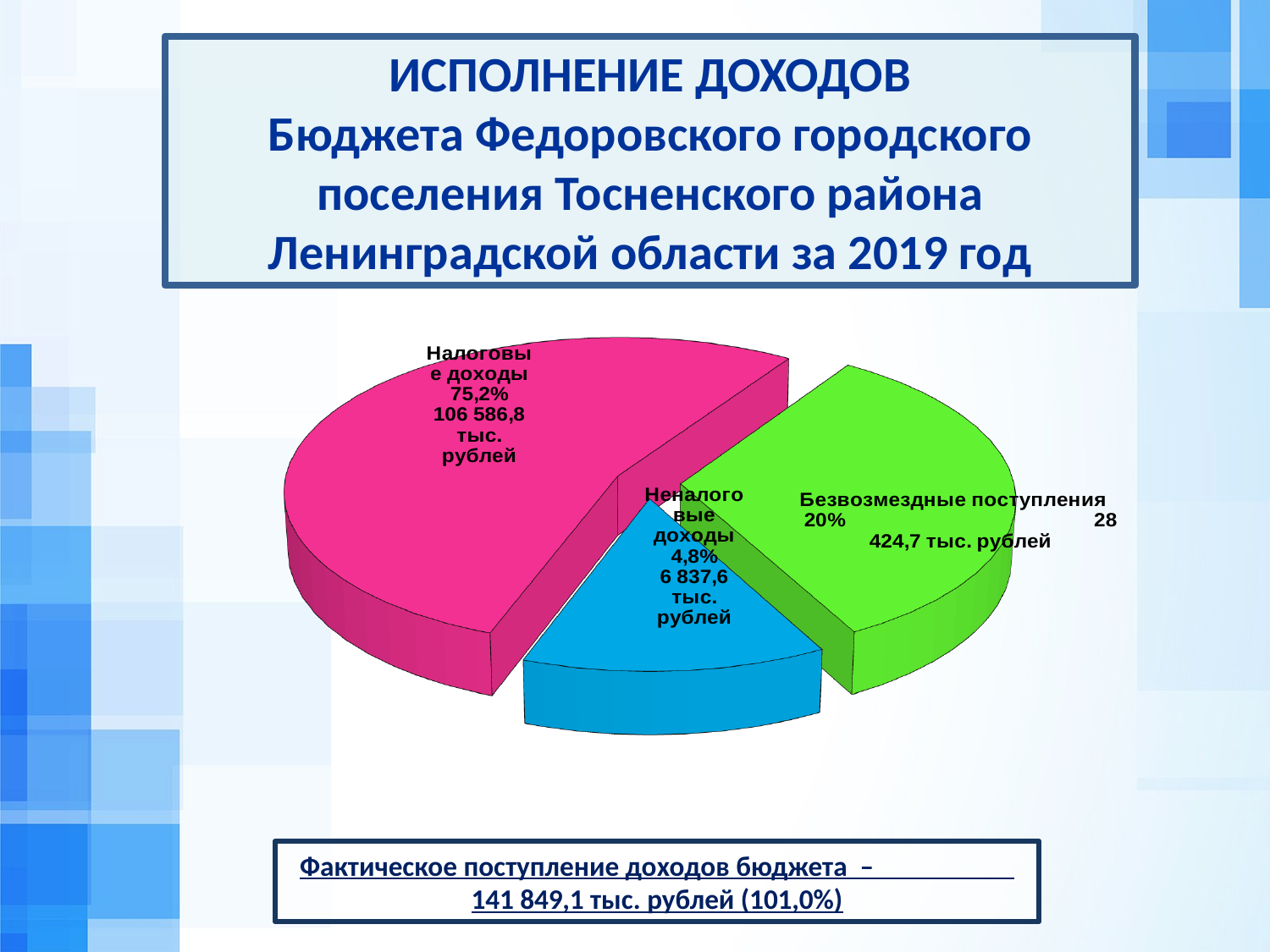
What is the value in тыс. рублей for Неналоговые доходы? 6 837,6 тыс. рублей Which category has the smallest slice of the pie? Неналоговые доходы What share of the pie does Безвозмездные поступления represent? 20% What is the value in тыс. рублей for Безвозмездные поступления? 28 424,7 тыс. рублей What kind of chart is shown on the slide? pie chart Which is larger, Безвозмездные поступления or Неналоговые доходы? Безвозмездные поступления What is the value in тыс. рублей for Налоговые доходы? 106 586,8 тыс. рублей What share of the pie does Налоговые доходы represent? 75,2% How many slices does the pie chart have? 3 What share of the pie does Неналоговые доходы represent? 4,8% What is the difference in тыс. рублей between Налоговые доходы and Безвозмездные поступления? 78 162,1 тыс. рублей Which category has the largest slice of the pie? Налоговые доходы